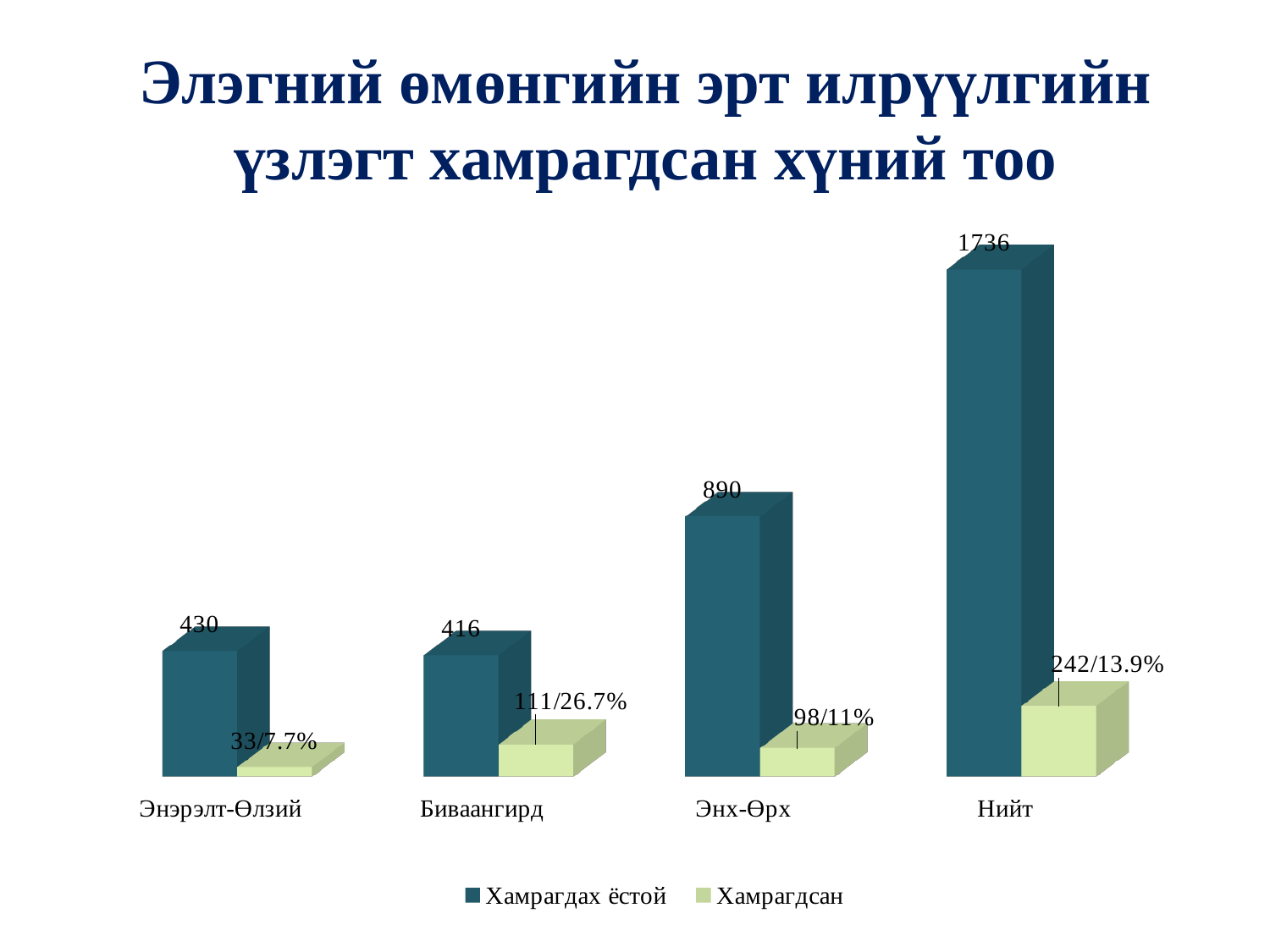
Which is larger, the Хамрагдах ёстой value for Энэрэлт-Өлзий or for Биваангирд? Энэрэлт-Өлзий Which series is shown in light green in the legend? Хамрагдсан What is the value of Хамрагдах ёстой for Нийт? 1736 What is the value of Хамрагдах ёстой for Энх-Өрх? 890 How many series does the legend list? 2 Which category has the highest Хамрагдах ёстой value? Нийт What data label is shown for Хамрагдсан at Энэрэлт-Өлзий? 33/7.7% What is the difference between the Хамрагдах ёстой values for Энх-Өрх and Биваангирд? 474 Which category has the lowest Хамрагдах ёстой value? Биваангирд What kind of chart is shown on the slide? Bar chart How many categories are shown on the x axis? 4 What data label is shown for Хамрагдсан at Биваангирд? 111/26.7%